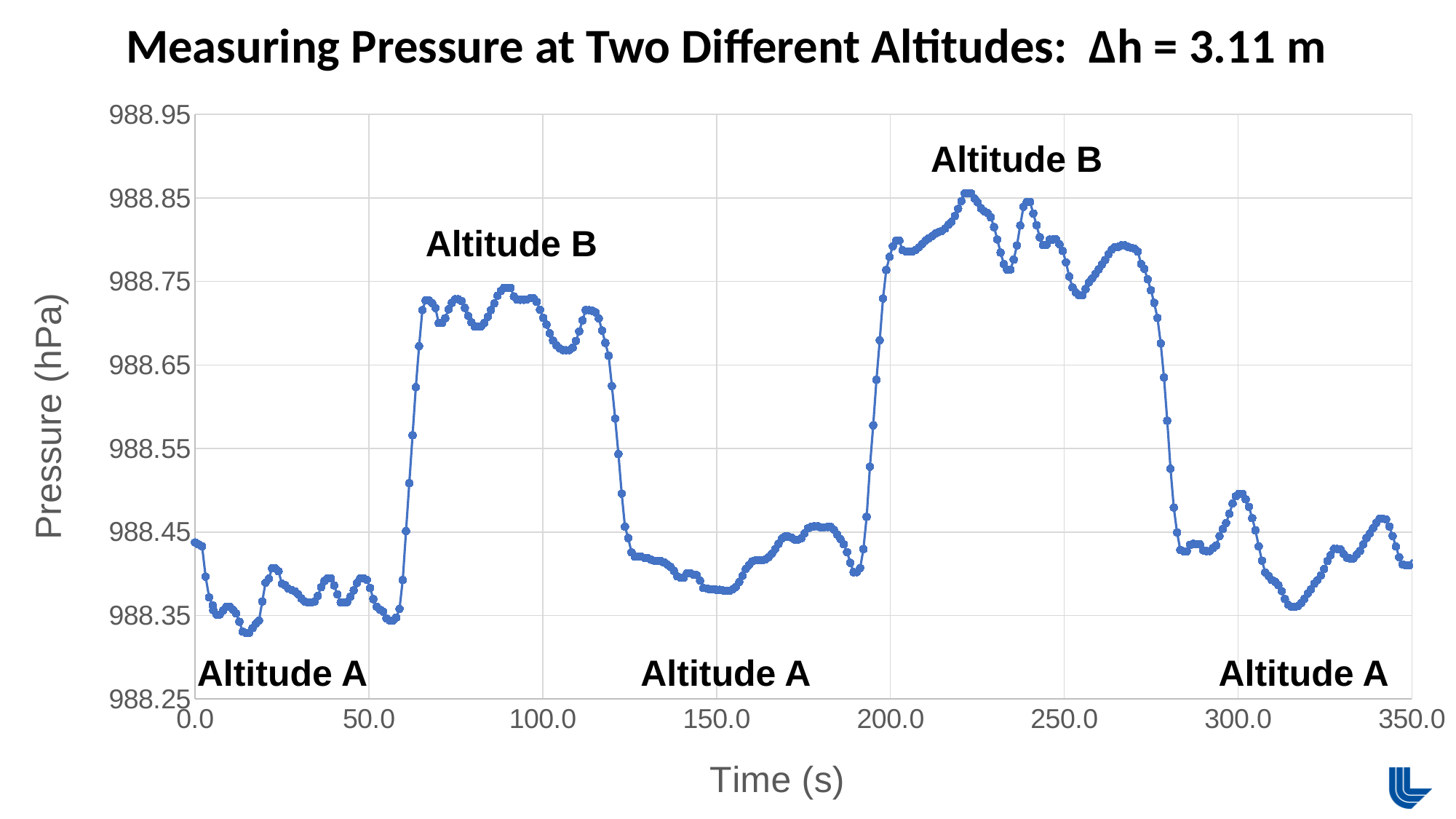
What kind of chart is shown on the slide? line chart Between 60 s and 70 s, does the pressure rise or fall? rise What is the title of the chart? Measuring Pressure at Two Different Altitudes: Δh = 3.11 m What is the label of the vertical axis? Pressure (hPa) Is the pressure at 100.0 s greater or less than 988.65 hPa? greater Is the pressure at 250.0 s greater or less than 988.75 hPa? greater Is the pressure at 0.0 s greater or less than 988.55 hPa? less Which altitude, A or B, corresponds to the higher measured pressure? Altitude B How many segments of the chart are labelled "Altitude A"? 3 Between 275 s and 285 s, does the pressure rise or fall? fall